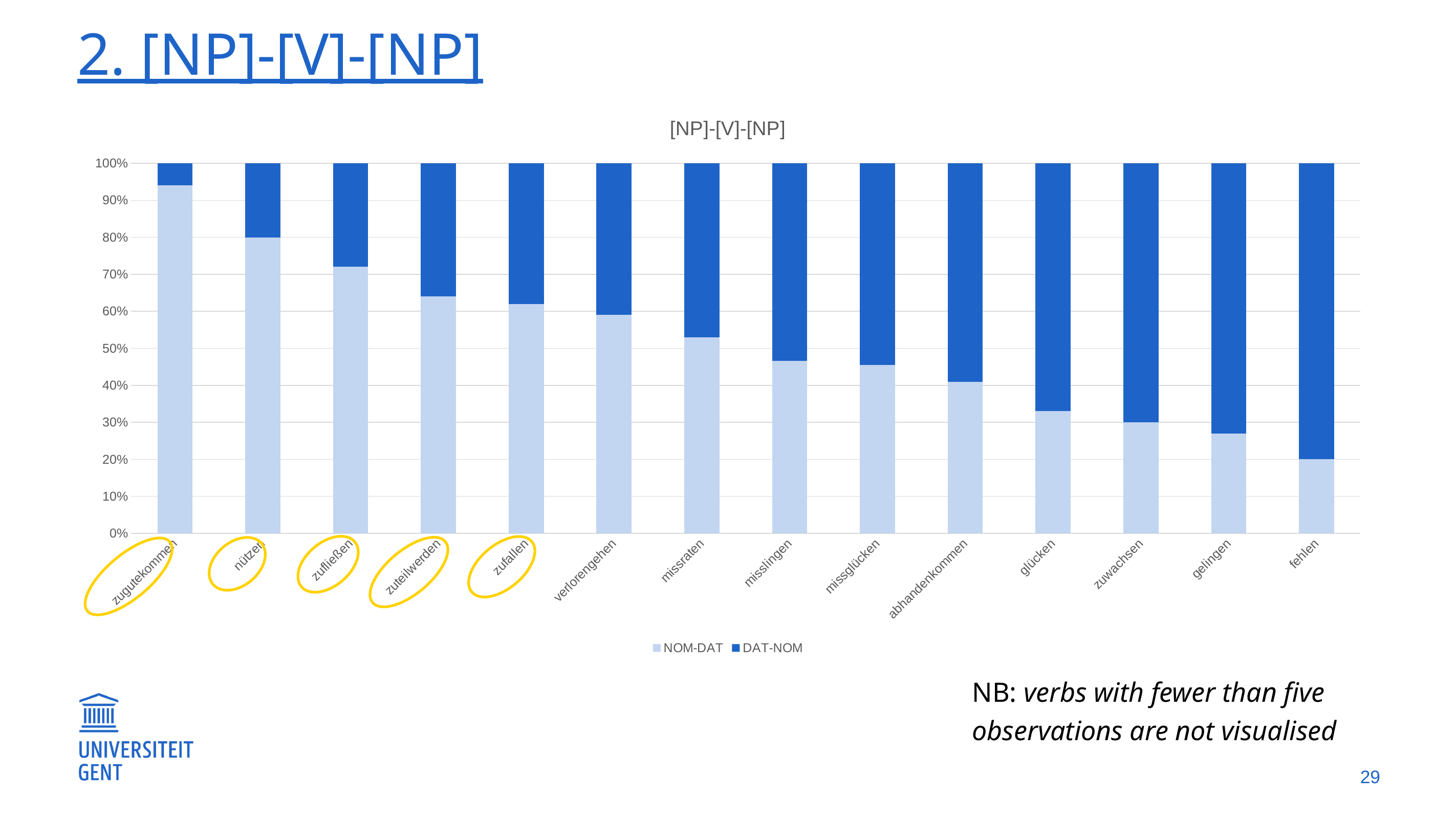
Does the NOM-DAT share rise or fall moving from left to right along the x axis? fall Which verb has the highest NOM-DAT share? zugutekommen Is the NOM-DAT share for zugutekommen greater or less than 90%? greater How many series does the legend list? 2 Which verb has a larger NOM-DAT share, zufließen or missraten? zufließen What is the total of the stacked bar for missraten? 100% Is the DAT-NOM share for verlorengehen greater or less than 50%? less Is the NOM-DAT share for glücken greater or less than 40%? less Which verb has the lowest NOM-DAT share? fehlen Which verb has the largest DAT-NOM share? fehlen What kind of chart is shown on the slide? Stacked bar chart How many verbs (categories) are plotted on the x axis? 14